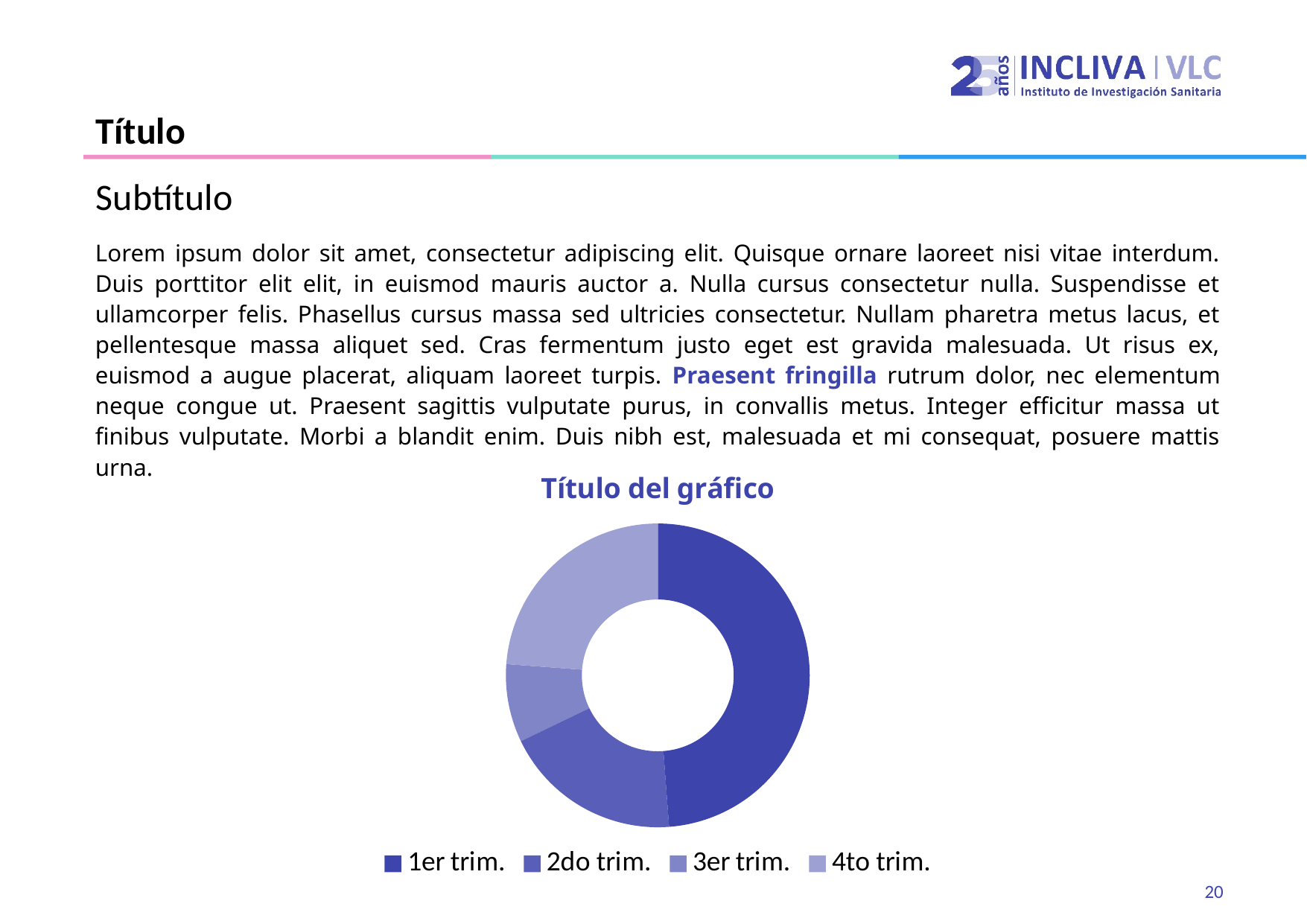
Which slice is larger, 4to trim. or 2do trim.? 4to trim. What is the title of the chart? Título del gráfico How many categories does the chart show? 4 Which category has the largest slice in the chart? 1er trim. Which category has the smallest slice in the chart? 3er trim. Which slice is larger, 1er trim. or 4to trim.? 1er trim. Which slice is larger, 2do trim. or 3er trim.? 2do trim. Which legend entry is listed first in the chart legend? 1er trim. How many entries does the chart legend list? 4 What kind of chart is shown on the slide? doughnut chart